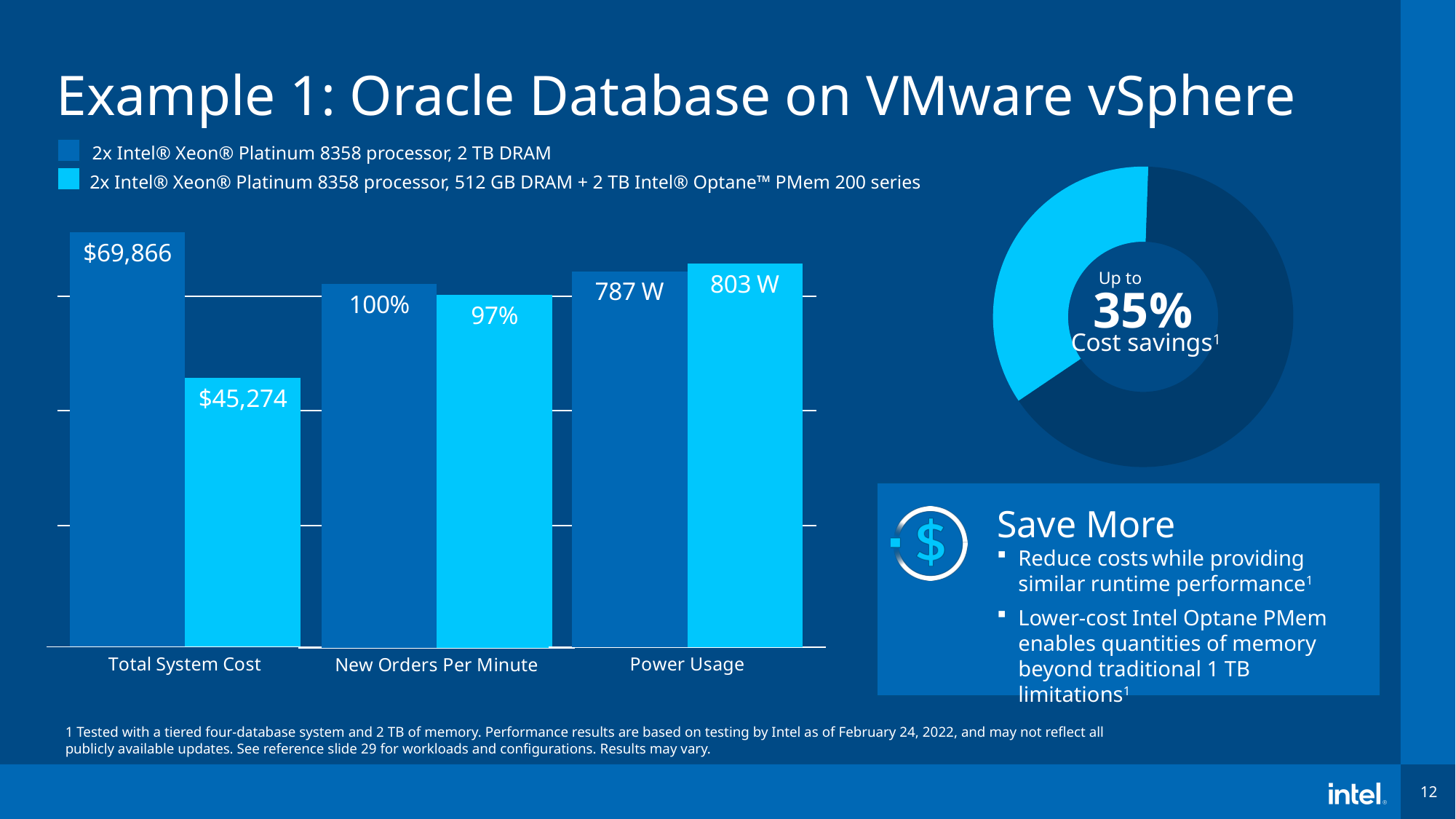
In the bar chart, what is the New Orders Per Minute value for the 512 GB DRAM + 2 TB Intel Optane PMem 200 series configuration? 97% In the bar chart, what is the Power Usage for the 2 TB DRAM configuration? 787 W In the bar chart, what is the Total System Cost for the configuration with 512 GB DRAM + 2 TB Intel Optane PMem 200 series? $45,274 In the bar chart, what is the Total System Cost for the 2x Intel Xeon Platinum 8358 processor, 2 TB DRAM configuration? $69,866 In the donut chart on the right, what cost savings percentage is shown? 35% In the bar chart, what is the difference in Power Usage between the two configurations? 16 W In the bar chart, which configuration has the higher New Orders Per Minute? 2x Intel Xeon Platinum 8358 processor, 2 TB DRAM How many series does the legend of the bar chart list? 2 How many categories are shown on the x axis of the bar chart? 3 In the bar chart, which configuration has the higher Power Usage? 2x Intel Xeon Platinum 8358 processor, 512 GB DRAM + 2 TB Intel Optane PMem 200 series In the bar chart, what is the difference in Total System Cost between the 2 TB DRAM configuration and the 512 GB DRAM + 2 TB Intel Optane PMem configuration? $24,592 What kind of chart is the chart on the left side of the slide? Bar chart